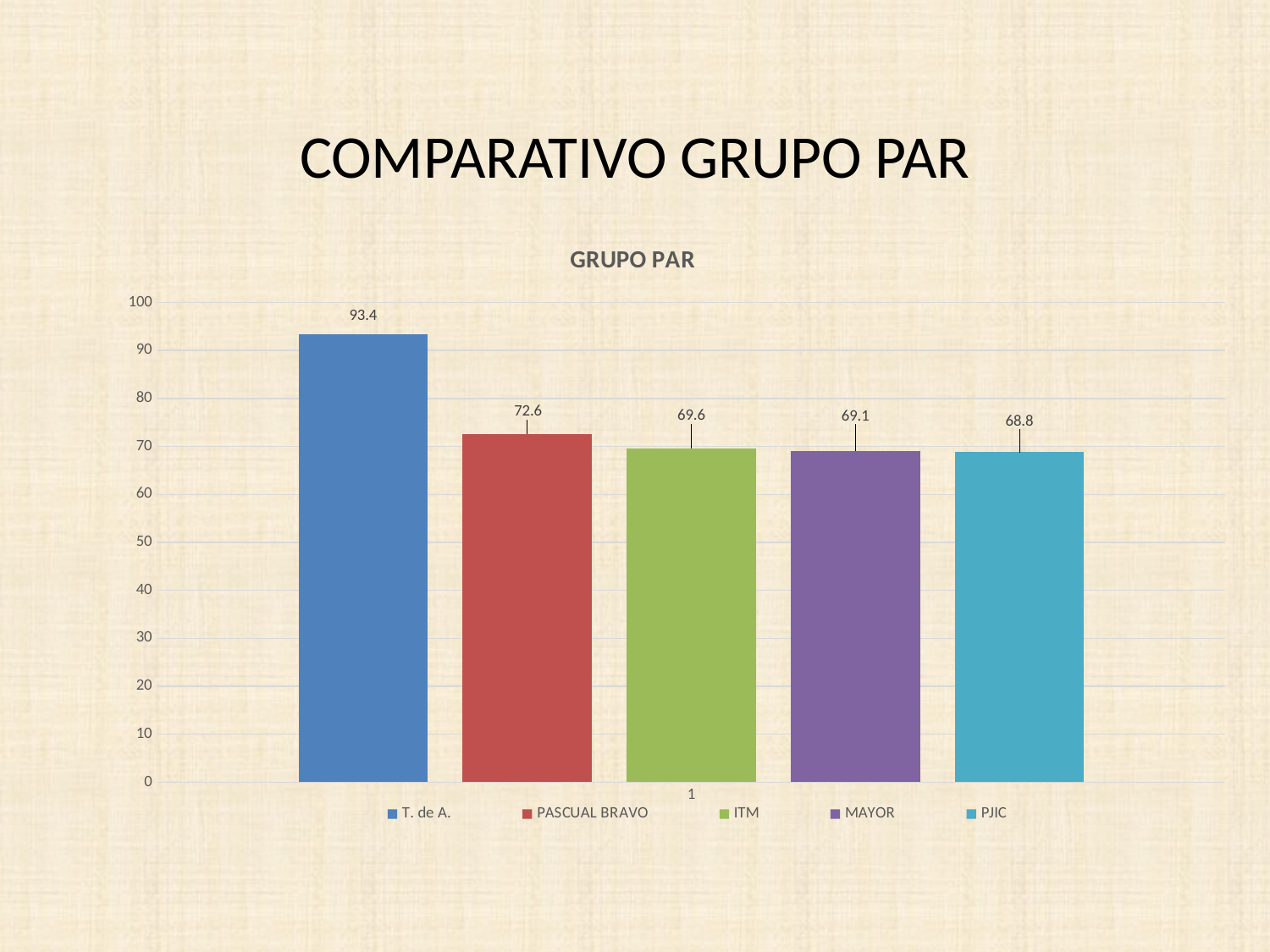
How many series does the legend list? 5 What is the value for PJIC? 68.8 What kind of chart is shown? Bar chart What is the value for PASCUAL BRAVO? 72.6 What is the value for T. de A.? 93.4 Which series has the highest value? T. de A. What is the difference between the values for T. de A. and PASCUAL BRAVO? 20.8 Which is larger, the value for PASCUAL BRAVO or the value for ITM? PASCUAL BRAVO What is the value for ITM? 69.6 Which series has the lowest value? PJIC What is the title of the chart? GRUPO PAR What is the value for MAYOR? 69.1